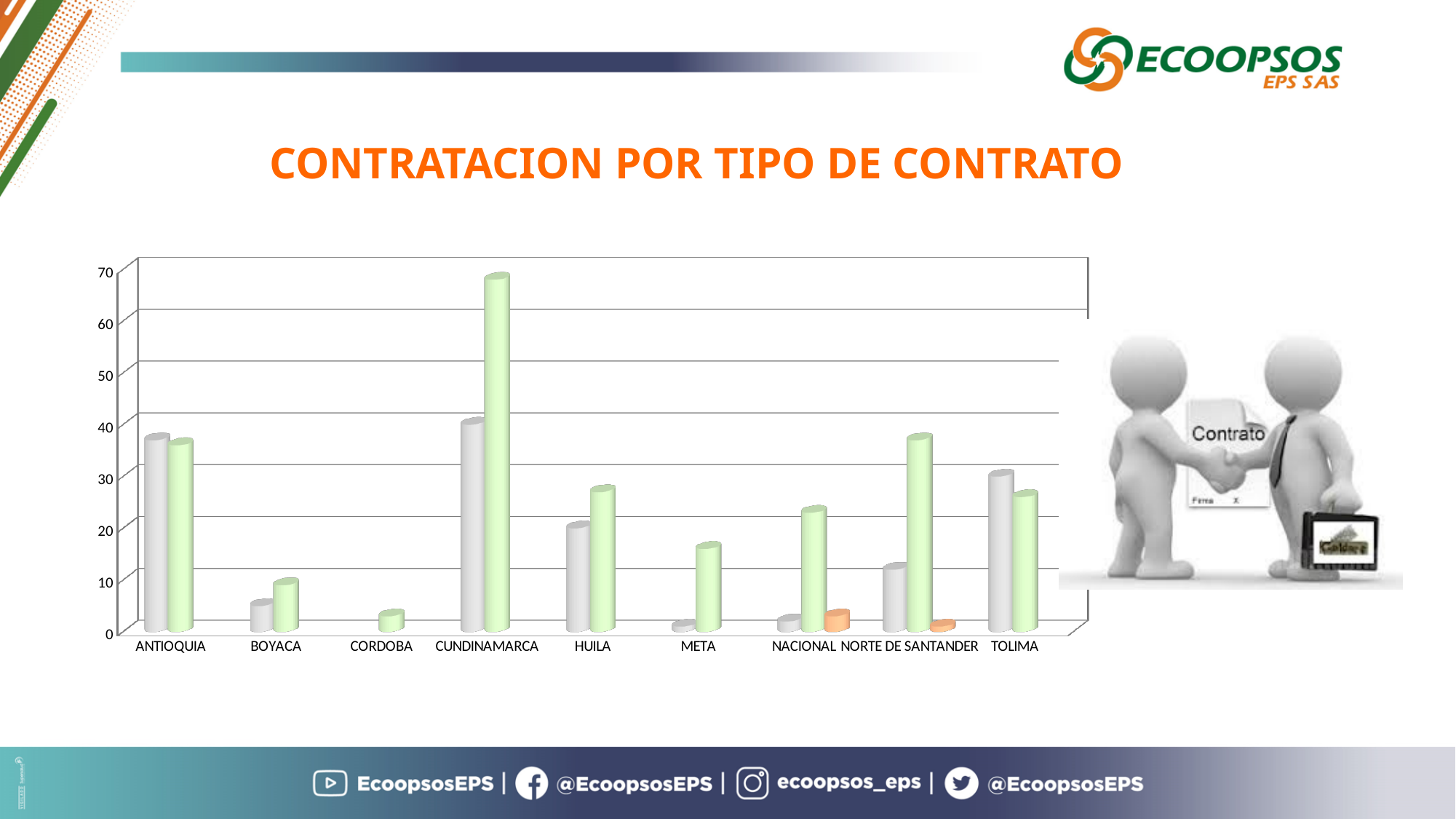
Is the green bar for NORTE DE SANTANDER greater or less than 30? greater Is the green bar for HUILA greater or less than 20? greater Which category has the tallest bar in the chart? CUNDINAMARCA Which is larger, the green bar for CUNDINAMARCA or the green bar for ANTIOQUIA? CUNDINAMARCA What kind of chart is shown on the slide? bar chart How many categories are shown on the x axis of the chart? 9 Is the green bar for CUNDINAMARCA greater or less than 60? greater Which category has the lowest green bar in the chart? CORDOBA What is the title shown above the chart? CONTRATACION POR TIPO DE CONTRATO Which categories have an orange bar in the chart? NACIONAL and NORTE DE SANTANDER